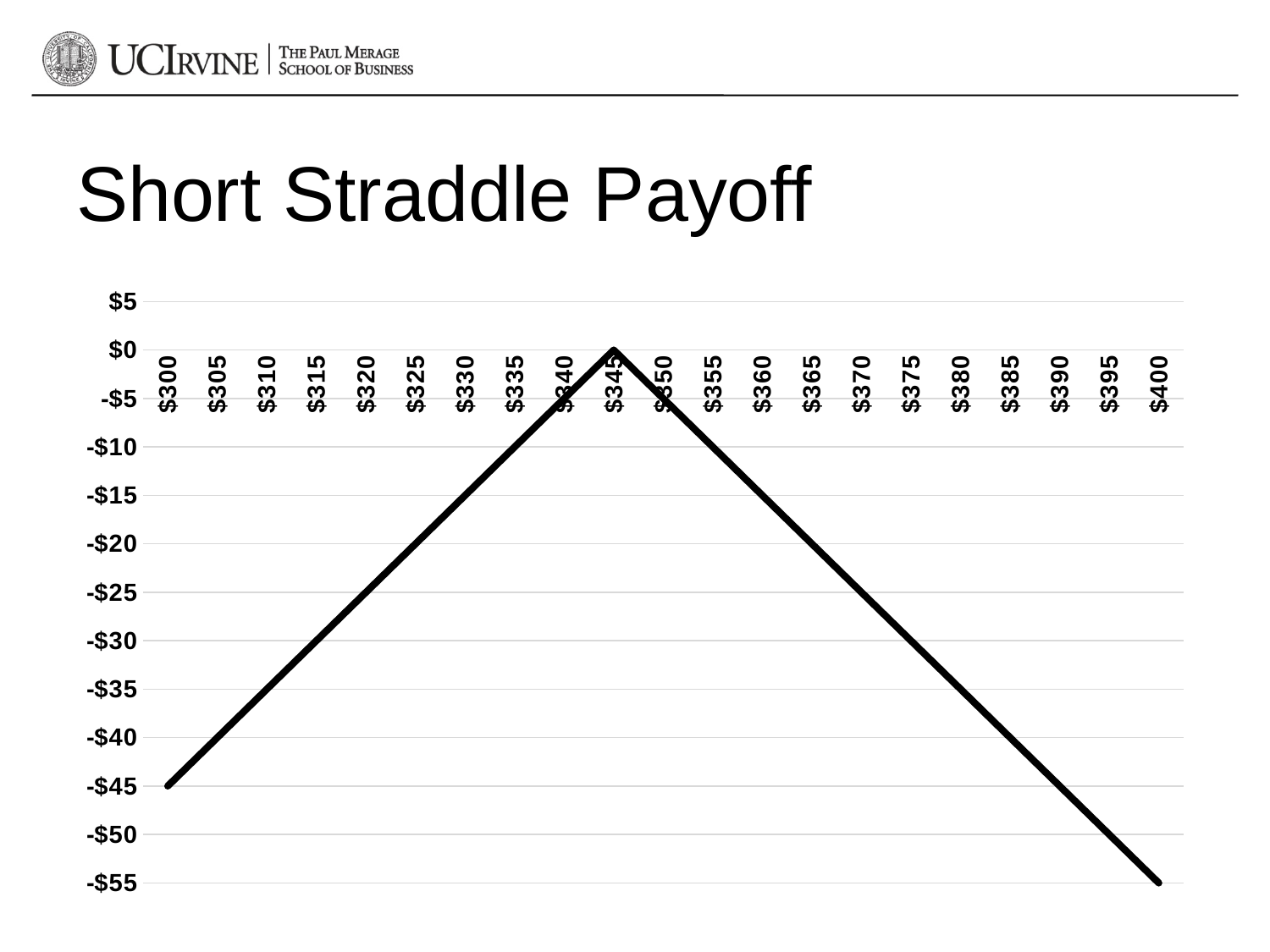
What is the payoff at a stock price of $400? -$55 At which stock price does the payoff reach its highest value? $345 What kind of chart is shown on the slide? line chart What is the payoff at a stock price of $300? -$45 How many price points are plotted along the x axis? 21 Is the payoff at $300 greater or less than -$40? less What is the title of the slide's chart? Short Straddle Payoff What is the payoff at a stock price of $345? $0 At which stock price is the payoff lowest? $400 Is the payoff at $370 greater or less than -$30? greater Does the payoff rise or fall as the stock price moves from $345 to $400? fall Which has the larger payoff, a stock price of $300 or $400? $300